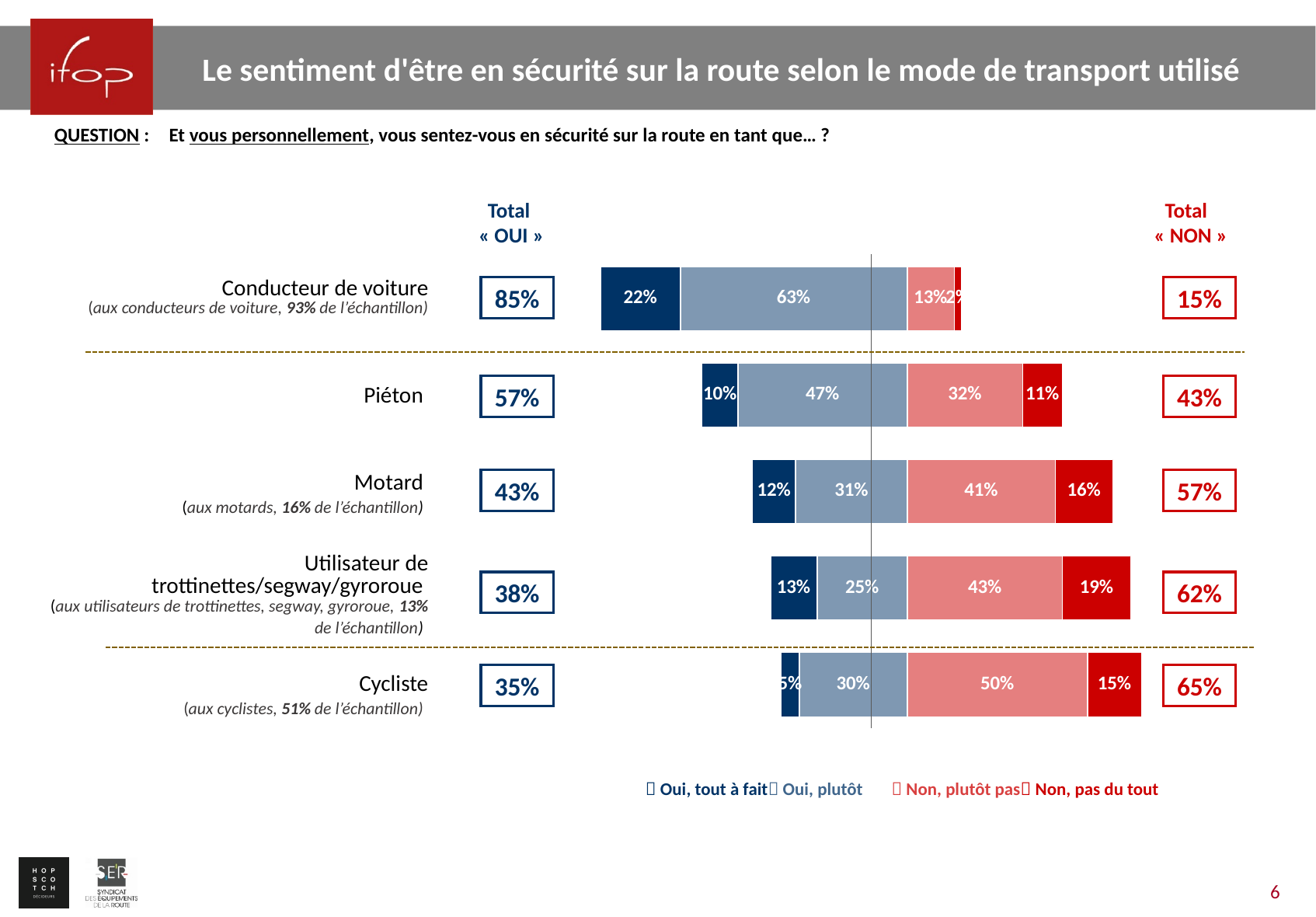
Which category has the lowest Total « OUI » value? Cycliste Which is larger: the 'Non, pas du tout' value for Utilisateur de trottinettes/segway/gyroroue or for Motard? Utilisateur de trottinettes/segway/gyroroue What is the Total « NON » value for Utilisateur de trottinettes/segway/gyroroue? 62% What kind of chart is shown on the slide? Stacked bar chart What is the 'Oui, plutôt' value for Piéton? 47% What is the difference between the 'Non, plutôt pas' values for Motard and Piéton? 9% What is the Total « OUI » value for Motard? 43% What is the 'Non, plutôt pas' value for Cycliste? 50% How many transport categories are shown in the chart? 5 How many series does the legend list? 4 What is the combined 'Oui, tout à fait' and 'Oui, plutôt' value for Piéton? 57% Which category has the highest Total « OUI » value? Conducteur de voiture